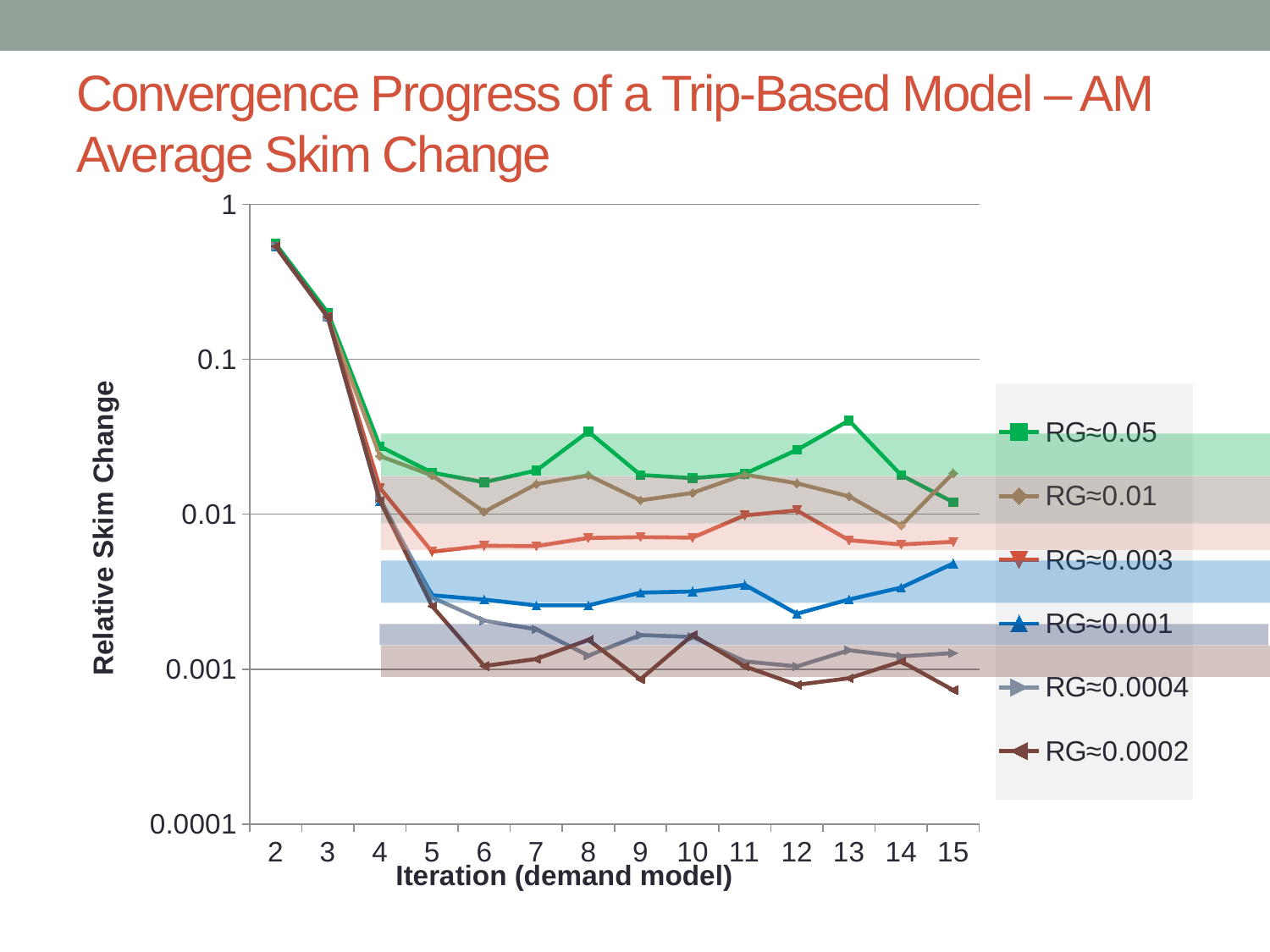
Is the value for RG≈0.05 at iteration 13 greater or less than 0.01? greater Which series has the lowest value at iteration 15? RG≈0.0002 Do the values for RG≈0.001 rise or fall from iteration 2 to iteration 5? fall Which series has the highest value at iteration 13? RG≈0.05 Is the value for RG≈0.05 at iteration 2 greater or less than 0.1? greater Is the value for RG≈0.001 at iteration 12 greater or less than 0.01? less How many iterations are plotted along the x axis? 14 At iteration 8, which series has the larger value, RG≈0.05 or RG≈0.001? RG≈0.05 What kind of chart is shown on the slide? Line chart How many series does the legend list? 6 What is the label on the y axis of the chart? Relative Skim Change